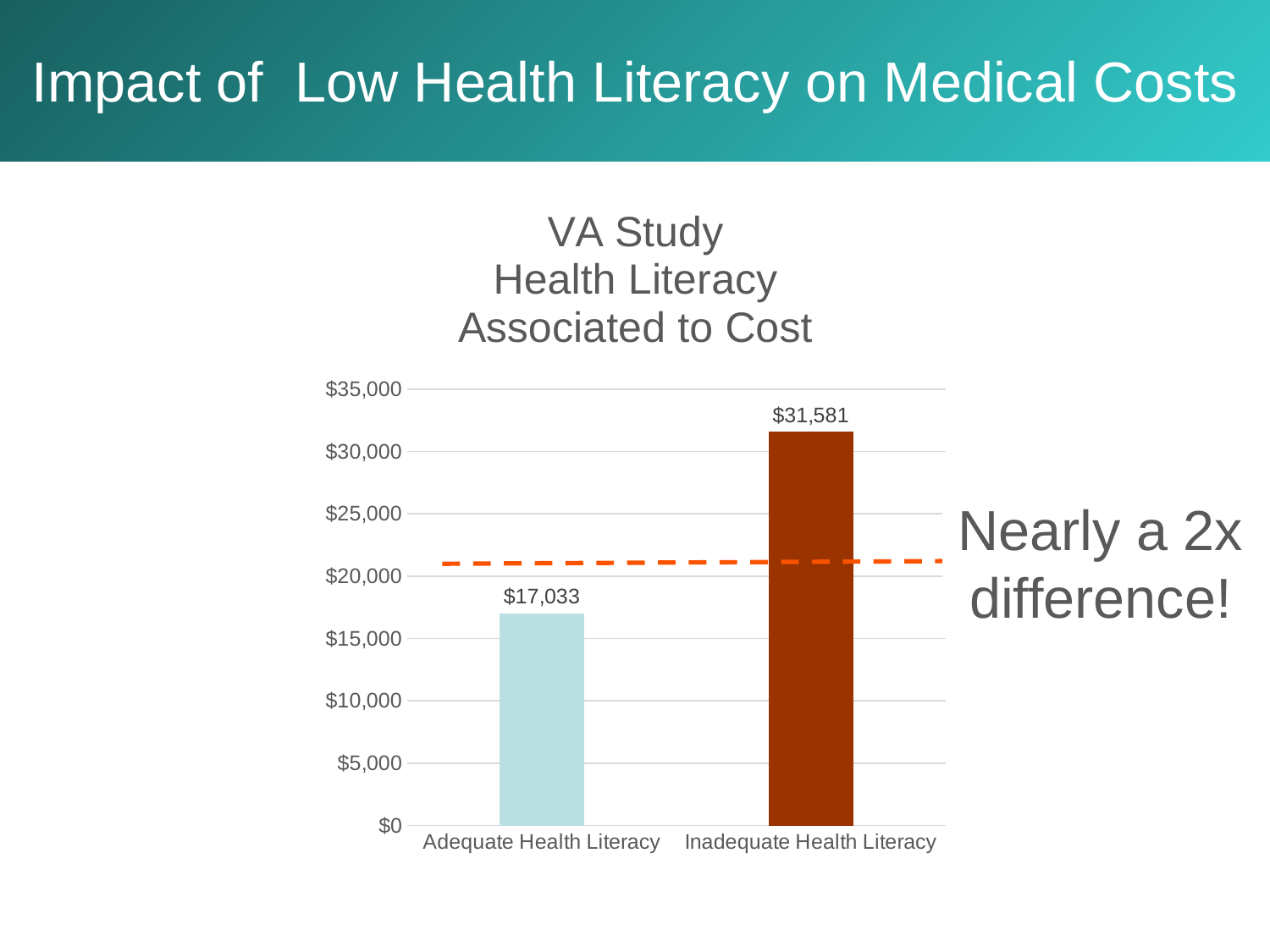
What is the title of the chart? VA Study Health Literacy Associated to Cost What kind of chart is shown on the slide? bar chart What is the highest value shown on the y axis? $35,000 Is the value for Adequate Health Literacy greater or less than $20,000? less What is the value for Inadequate Health Literacy? $31,581 What is the difference between the values for Inadequate Health Literacy and Adequate Health Literacy? $14,548 Which category has the highest value? Inadequate Health Literacy Which category has the lowest value? Adequate Health Literacy Which is larger, the value for Adequate Health Literacy or the value for Inadequate Health Literacy? Inadequate Health Literacy What is the value for Adequate Health Literacy? $17,033 How many categories are shown on the x axis? 2 Is the value for Inadequate Health Literacy greater or less than $30,000? greater